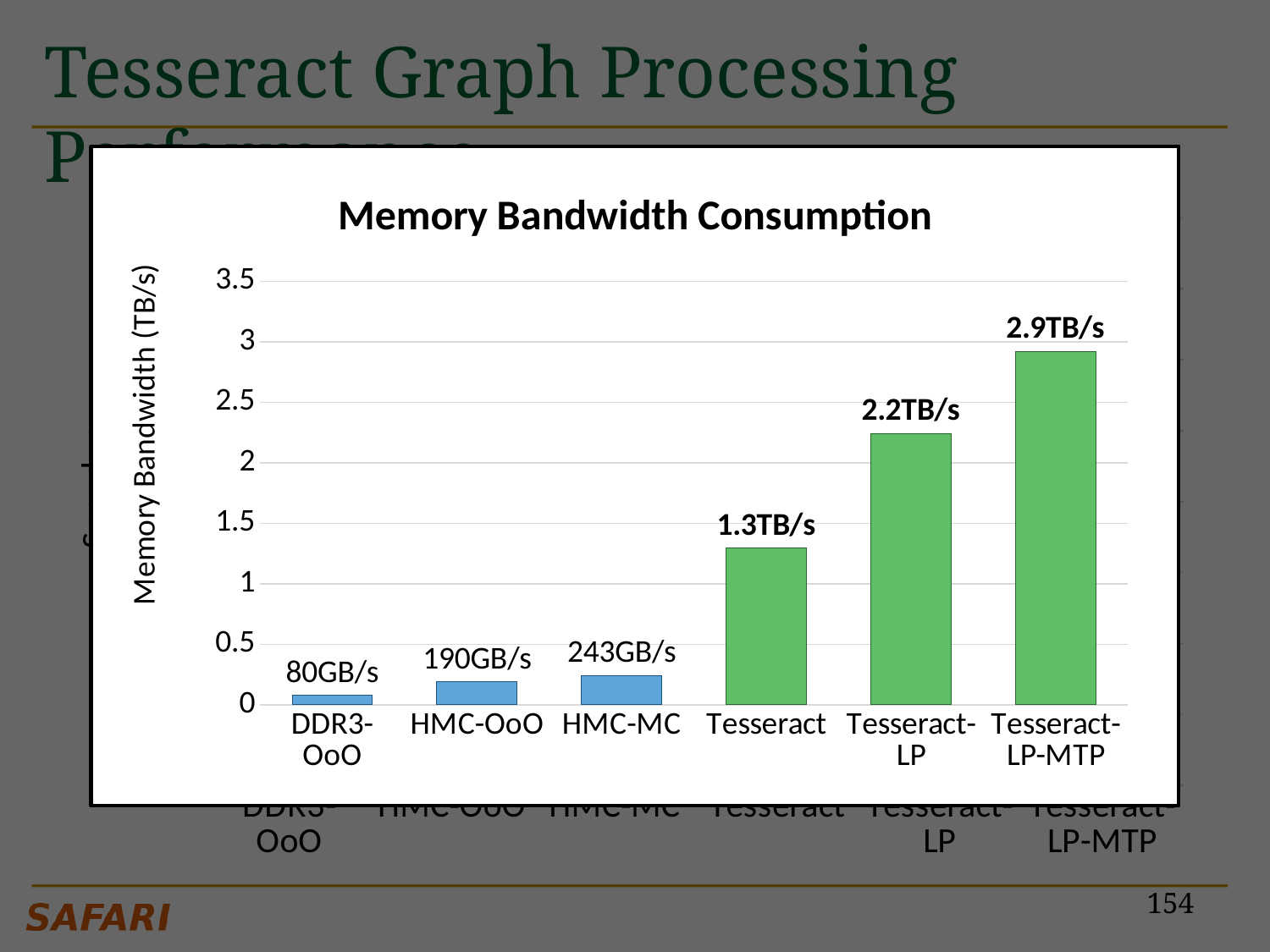
Which has higher memory bandwidth consumption, HMC-OoO or Tesseract? Tesseract Which category has the lowest memory bandwidth consumption? DDR3-OoO What is the memory bandwidth value shown for HMC-MC? 243GB/s Is the value for Tesseract-LP-MTP greater or less than 2.5? greater Which category has the highest memory bandwidth consumption? Tesseract-LP-MTP What kind of chart is shown on the slide? bar chart What is the memory bandwidth value shown for Tesseract-LP-MTP? 2.9TB/s How many categories are shown on the x axis of the chart? 6 What is the memory bandwidth value shown for Tesseract-LP? 2.2TB/s Do the values rise or fall from left to right along the x axis? rise What is the difference in memory bandwidth between Tesseract-LP-MTP and Tesseract-LP? 0.7TB/s What is the memory bandwidth value shown for DDR3-OoO? 80GB/s